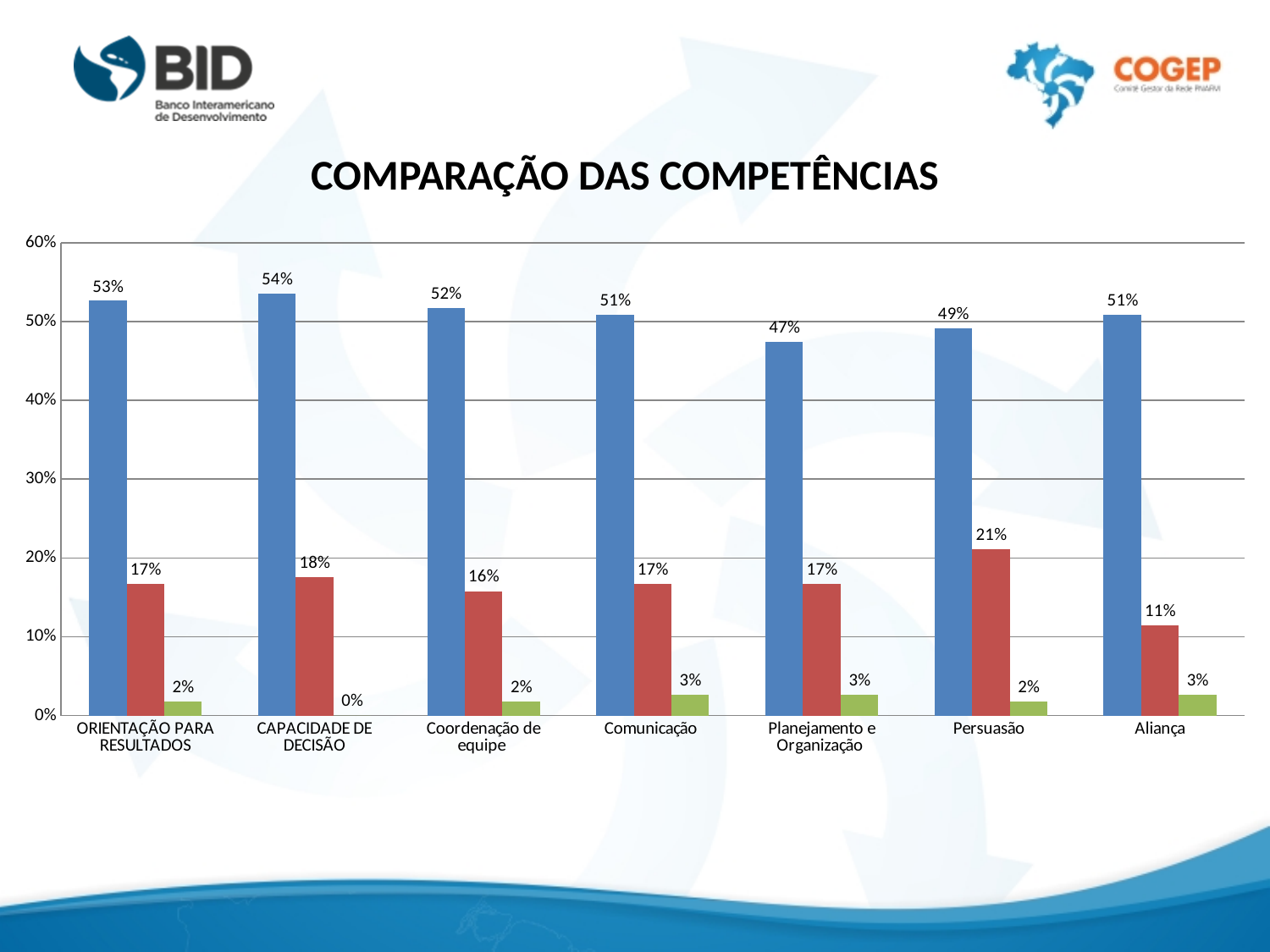
What is the value of the red bar for Coordenação de equipe? 16% What type of chart is shown on the slide? Bar chart What is the title of the chart? COMPARAÇÃO DAS COMPETÊNCIAS Which category has the lowest red bar? Aliança What is the value of the blue bar for CAPACIDADE DE DECISÃO? 54% How many categories are shown on the x axis? 7 What is the value of the green bar for Aliança? 3% Which category has the lowest blue bar? Planejamento e Organização What is the value of the red bar for Persuasão? 21% What is the difference between the blue bar for CAPACIDADE DE DECISÃO and the blue bar for Planejamento e Organização? 7% Which is larger: the red bar for Persuasão or the red bar for Comunicação? Persuasão Which category has the highest blue bar? CAPACIDADE DE DECISÃO